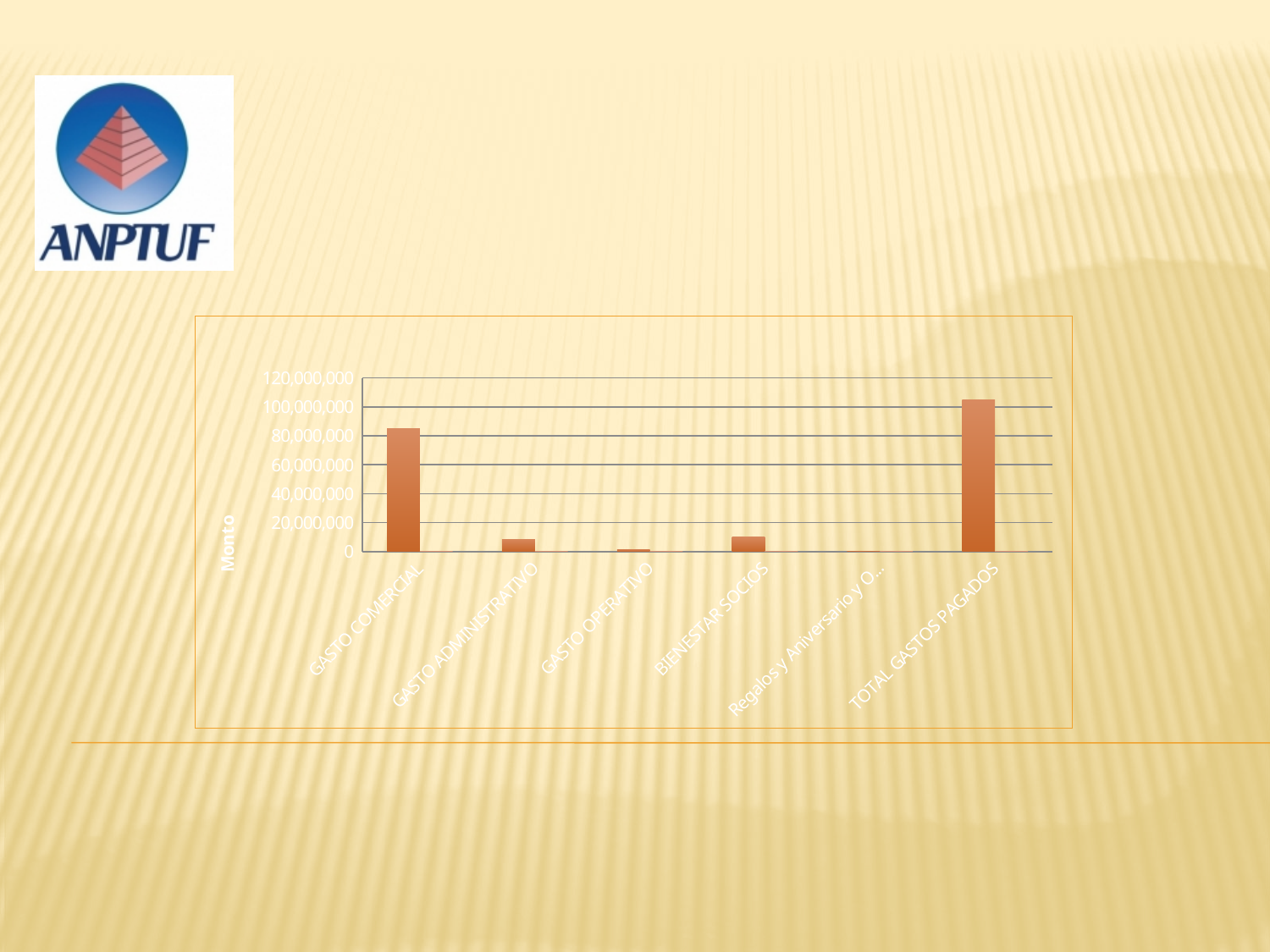
Which is larger, the value for GASTO ADMINISTRATIVO or the value for GASTO OPERATIVO? GASTO ADMINISTRATIVO Is the value for GASTO OPERATIVO greater or less than 20,000,000? less Is the value for GASTO ADMINISTRATIVO greater or less than 20,000,000? less What kind of chart is shown on the slide? bar chart What is the title of the vertical axis of the chart? Monto What is the highest tick value shown on the vertical axis of the chart? 120,000,000 Is the value for GASTO COMERCIAL greater or less than 60,000,000? greater Which category has the highest bar in the chart? TOTAL GASTOS PAGADOS How many categories are plotted on the x axis of the chart? 6 Which is larger, the value for GASTO COMERCIAL or the value for TOTAL GASTOS PAGADOS? TOTAL GASTOS PAGADOS